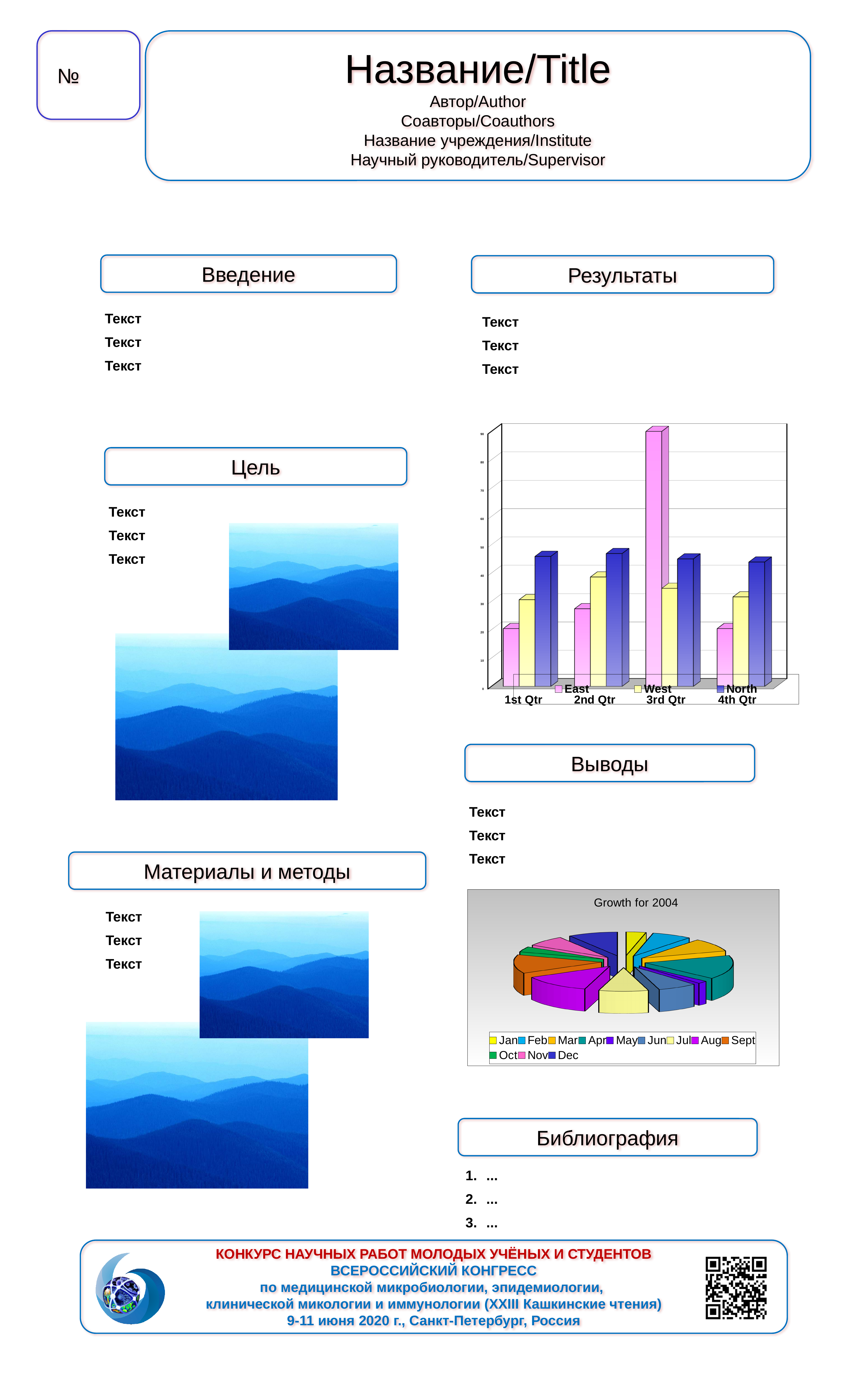
In the bar chart with East, West and North series, is the value for East in 1st Qtr greater or less than 30? less In the bar chart with East, West and North series, how many quarter categories are shown on the x axis? 4 In the bar chart with East, West and North series, which series has the lowest bar in 1st Qtr? East In the bar chart with East, West and North series, is the value for East in 3rd Qtr greater or less than 80? greater What kind of chart is the chart titled 'Growth for 2004'? pie chart What kind of chart is the chart in the Результаты section with East, West and North series? bar chart In the bar chart with East, West and North series, which is larger in 1st Qtr: North or East? North In the bar chart with East, West and North series, is the value for North in 1st Qtr greater or less than 40? greater In the chart titled 'Growth for 2004', how many entries does the legend list? 12 In the bar chart with East, West and North series, how many series does the legend list? 3 What is the title of the pie chart in the Выводы section? Growth for 2004 In the bar chart with East, West and North series, which series has the tallest bar in 3rd Qtr? East